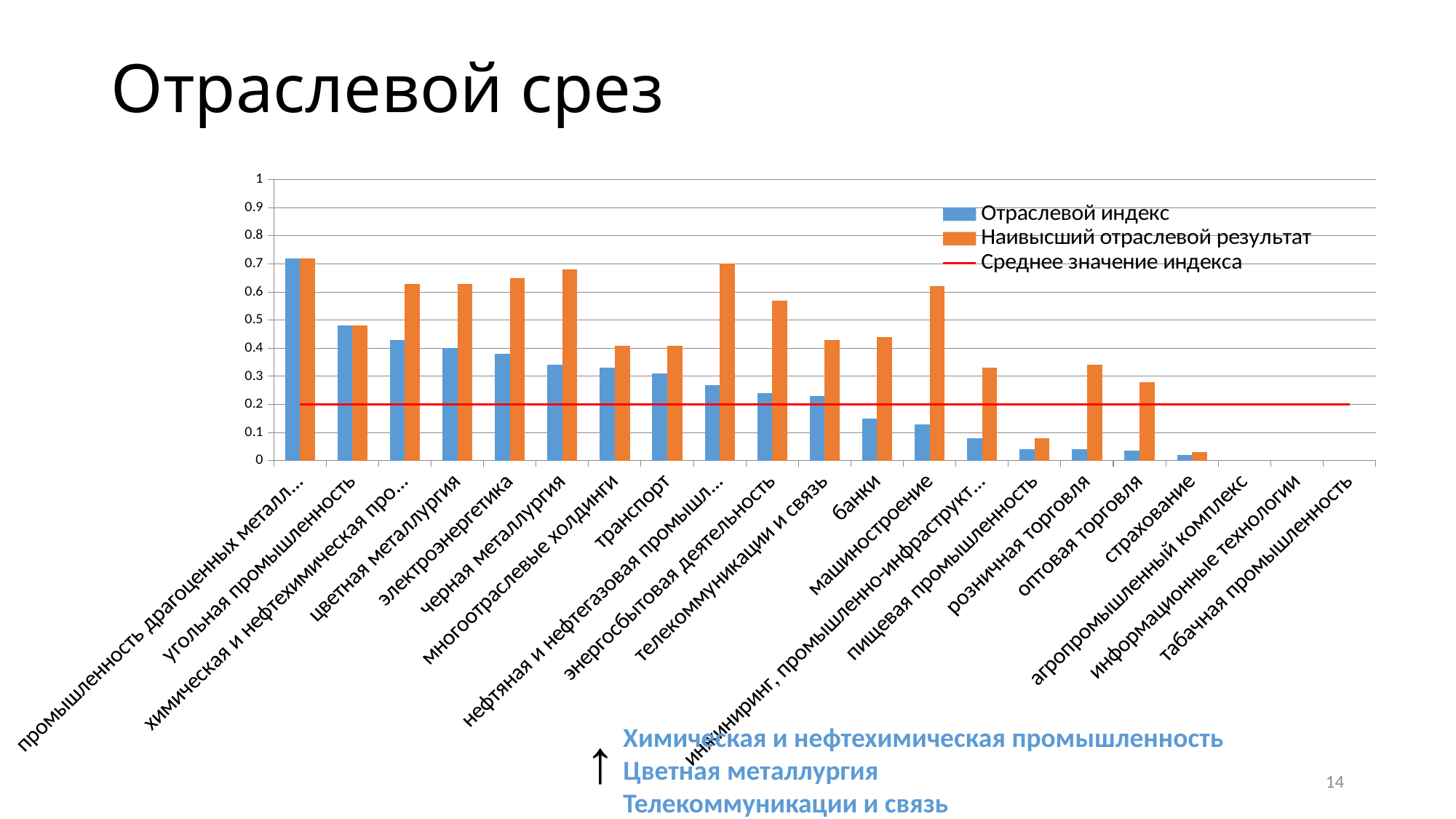
Is the Наивысший отраслевой результат value for черная металлургия greater or less than 0.6? greater What is the value of the Среднее значение индекса line? 0.2 How many series does the legend list? 3 Which has the larger Наивысший отраслевой результат value: энергосбытовая деятельность or телекоммуникации и связь? энергосбытовая деятельность Which category has the highest value for Отраслевой индекс? промышленность драгоценных металлов What colour are the bars for the Наивысший отраслевой результат series? orange Is the Отраслевой индекс value for банки greater or less than 0.2? less Is the Наивысший отраслевой результат value for электроэнергетика greater or less than 0.6? greater What kind of chart is shown on the slide? bar chart Do the values for Отраслевой индекс rise or fall from left to right along the x axis? fall How many industry categories are shown on the x axis? 21 Which has the larger Отраслевой индекс value: угольная промышленность or цветная металлургия? угольная промышленность